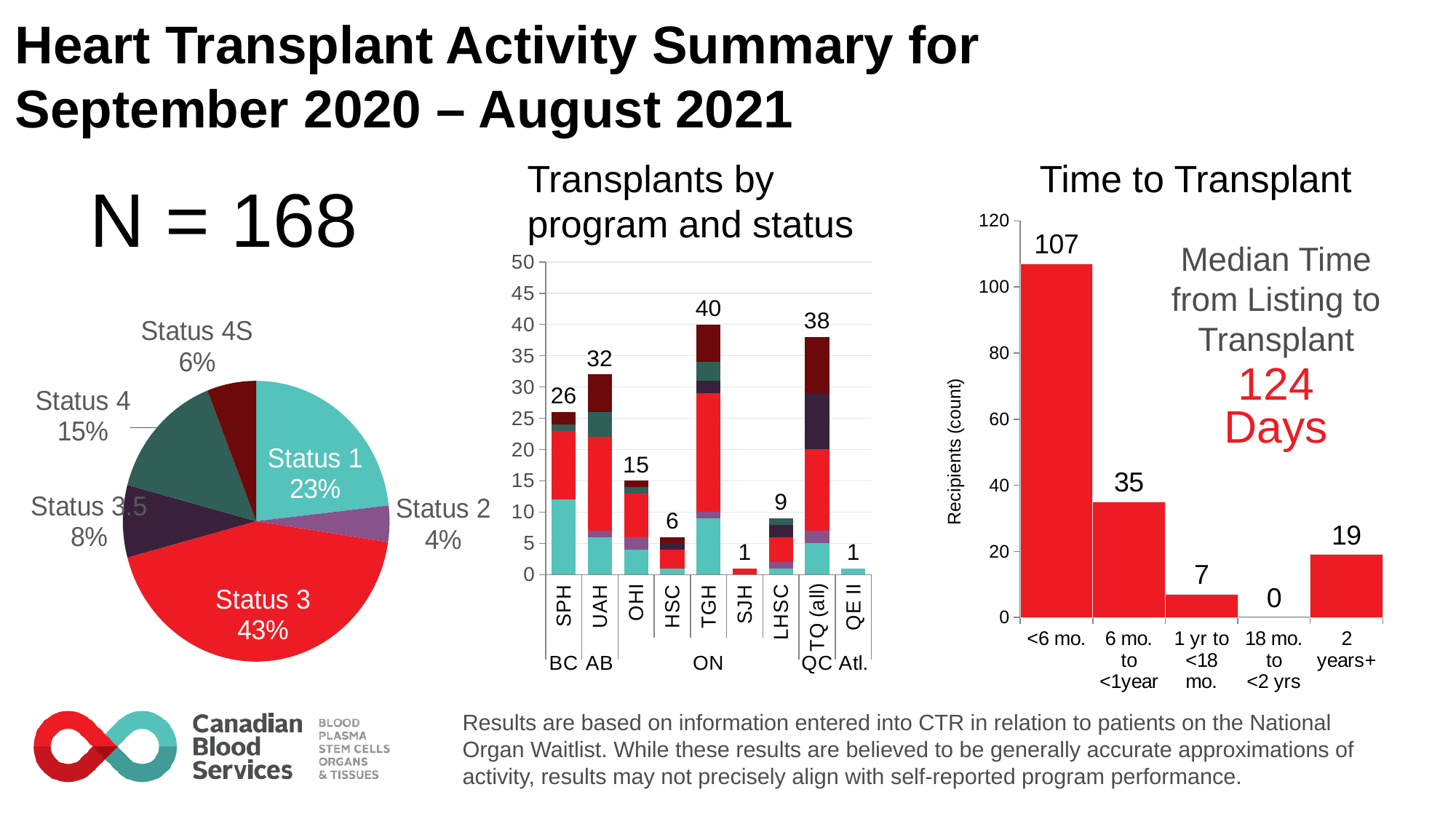
In the 'Transplants by program and status' chart, which program has the highest total? TGH In the 'Time to Transplant' chart, how many recipients are in the '<6 mo.' category? 107 What kind of chart is 'Transplants by program and status'? Stacked bar chart In the 'Transplants by program and status' chart, what is the total number of transplants for TGH? 40 In the 'Time to Transplant' chart, what is the difference between the '<6 mo.' and '6 mo. to <1year' values? 72 In the 'Time to Transplant' chart, which is larger: '2 years+' or '1 yr to <18 mo.'? 2 years+ In the pie chart on the left, which status has the largest share? Status 3 How many programs are shown on the x axis of the 'Transplants by program and status' chart? 9 How many slices does the pie chart on the left have? 6 In the 'Transplants by program and status' chart, what is the difference between the totals for TGH and TQ (all)? 2 In the pie chart on the left, what share of transplants is Status 3? 43% In the pie chart on the left, which status has the smallest share? Status 2